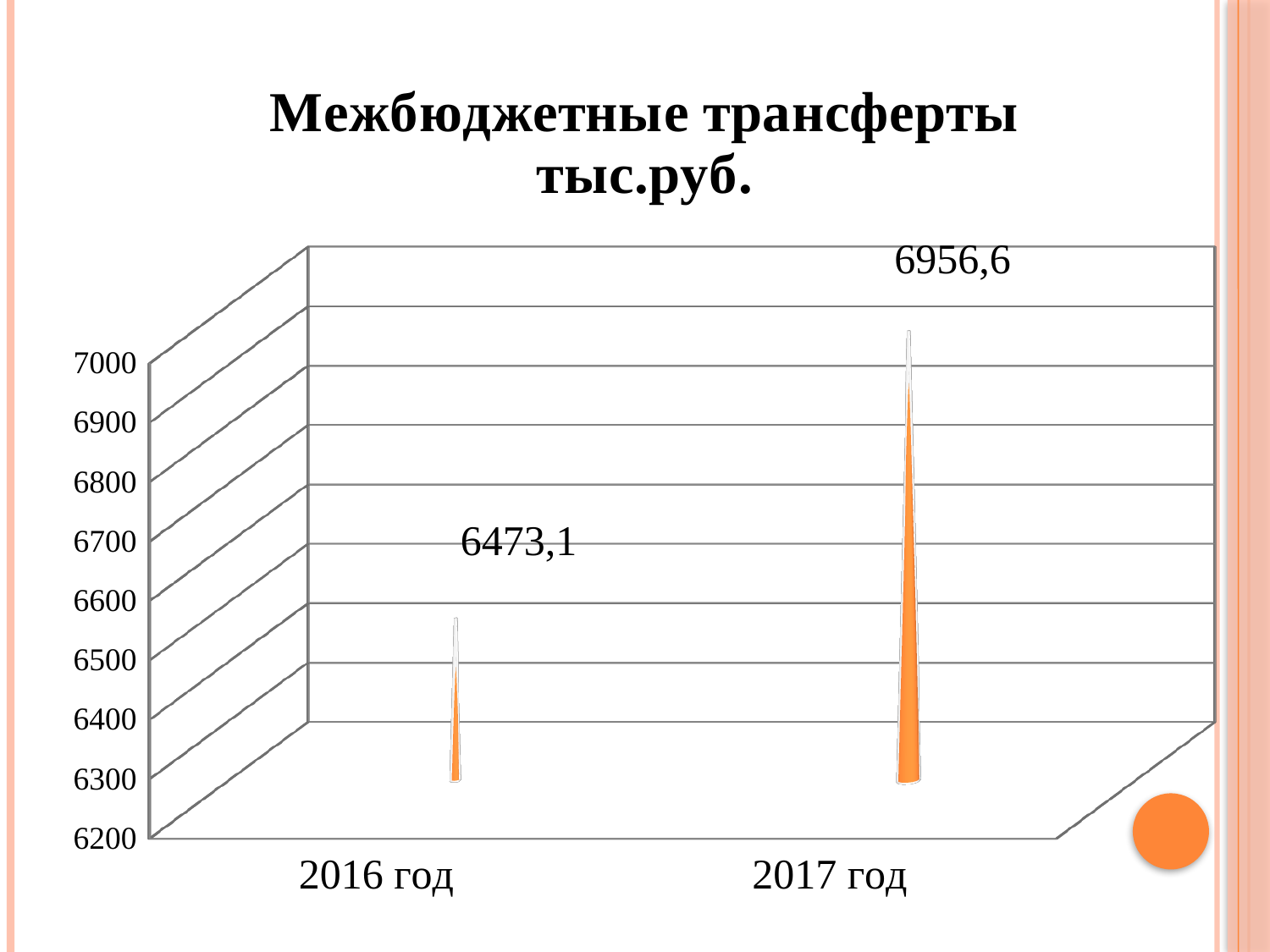
Is the value for 2016 год greater or less than 6500? less Which year has the highest value? 2017 год Is the value for 2017 год greater or less than 6900? greater Which is larger, the value for 2016 год or the value for 2017 год? 2017 год How many categories are shown on the x axis? 2 What is the value for 2016 год? 6473,1 What kind of chart is shown on the slide? bar chart What is the title of the chart? Межбюджетные трансферты тыс.руб. What is the difference between the values for 2017 год and 2016 год? 483,5 What is the value for 2017 год? 6956,6 Do the values rise or fall from 2016 год to 2017 год? rise Which year has the lowest value? 2016 год